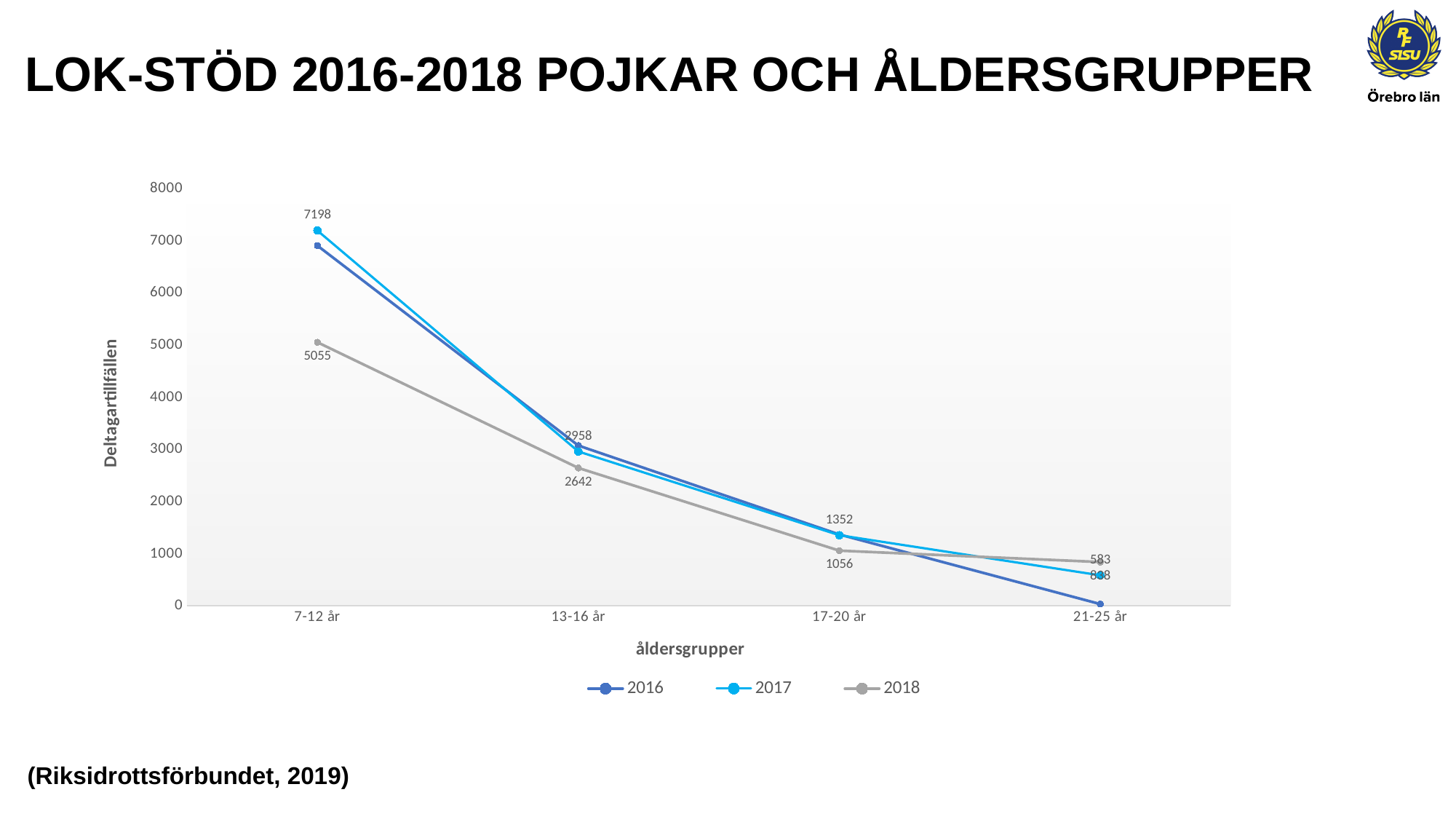
What kind of chart is shown on the slide? line chart Do the values for the 2017 series rise or fall from 7-12 år to 21-25 år? fall What is the value for 2018 in the 13-16 år age group? 2642 What is the difference between the 2017 and 2018 values in the 7-12 år age group? 2143 How many age groups are shown on the x axis? 4 Is the value for 2016 in the 7-12 år age group greater or less than 6000? greater What is the value for 2017 in the 7-12 år age group? 7198 How many series does the legend list? 3 Which age group has the highest value for the 2018 series? 7-12 år What is the value for 2018 in the 7-12 år age group? 5055 What is the value for 2018 in the 21-25 år age group? 838 What is the value for 2017 in the 17-20 år age group? 1352